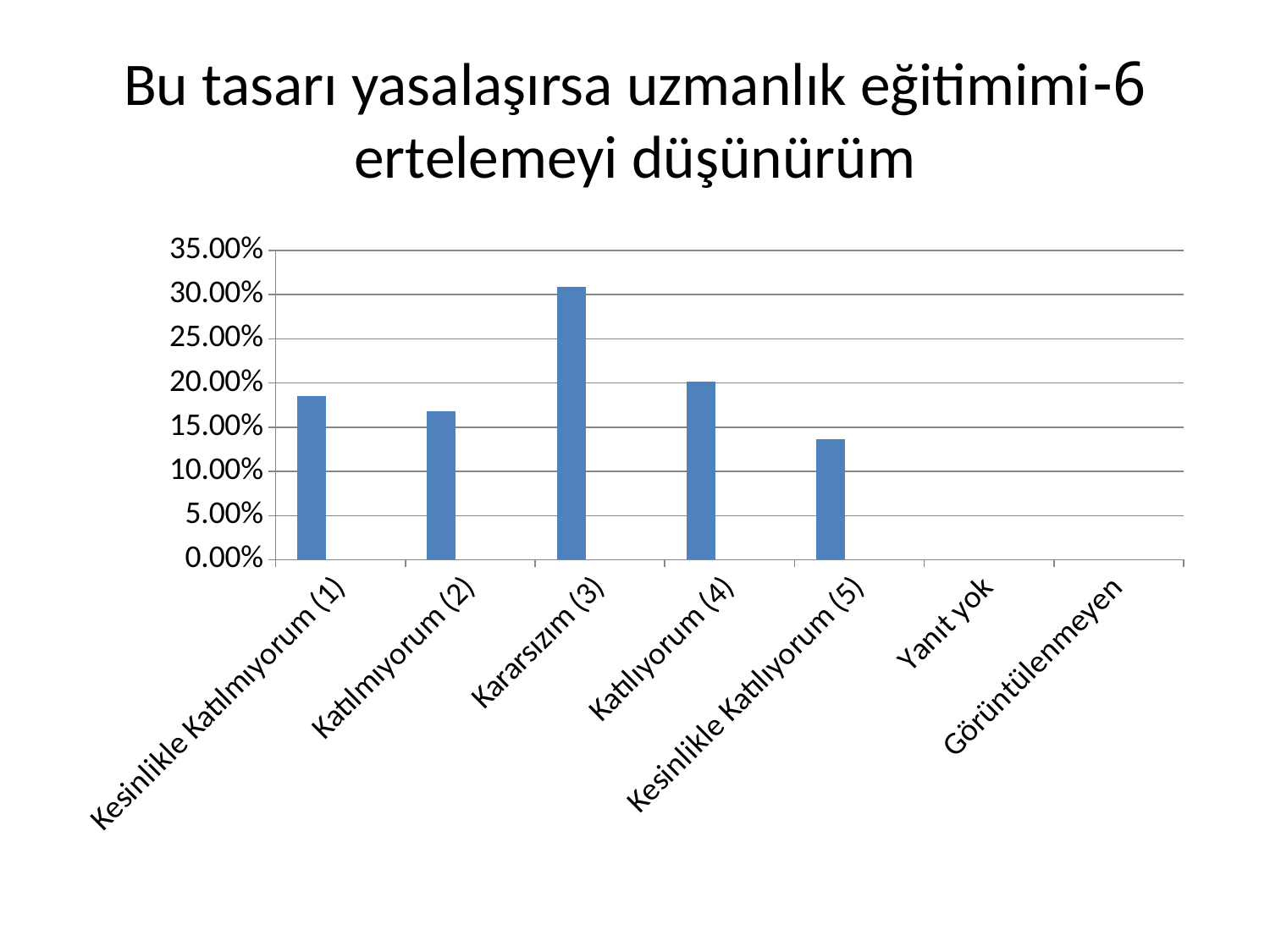
Is the value for Katılıyorum (4) greater or less than 25.00%? less How many categories are listed along the x axis of the chart? 7 Among the five categories with visible bars, which has the lowest value? Kesinlikle Katılıyorum (5) Is the value for Kesinlikle Katılıyorum (5) greater or less than 15.00%? less Is the value for Kararsızım (3) greater or less than 25.00%? greater Which category has the highest value in the chart? Kararsızım (3) Which is larger, the value for Kararsızım (3) or the value for Katılıyorum (4)? Kararsızım (3) What is the highest value shown on the chart's vertical axis? 35.00% Which is larger, the value for Kesinlikle Katılmıyorum (1) or the value for Katılmıyorum (2)? Kesinlikle Katılmıyorum (1) What kind of chart is shown on the slide? bar chart